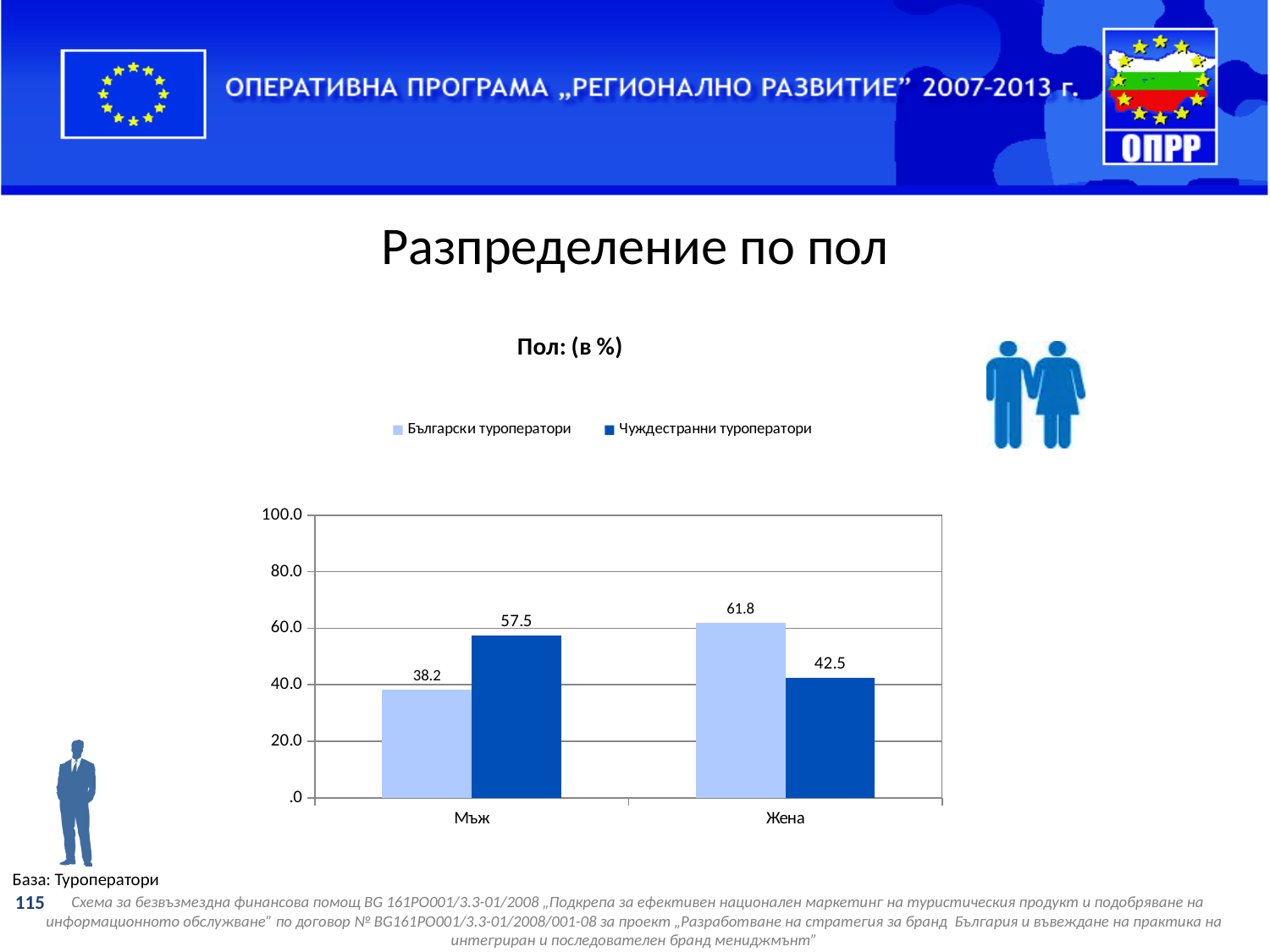
What is the value for Чуждестранни туроператори in the Мъж category? 57.5 What is the value for Чуждестранни туроператори in the Жена category? 42.5 What kind of chart is shown on the slide? Bar chart Which category has the highest value for Български туроператори? Жена What is the difference between the Чуждестранни туроператори and Български туроператори values in the Мъж category? 19.3 How many categories are shown on the x axis? 2 What is the value for Български туроператори in the Жена category? 61.8 Which category has the lowest value for Чуждестранни туроператори? Жена What is the title of the chart? Пол: (в %) How many series does the legend list? 2 What is the value for Български туроператори in the Мъж category? 38.2 Which is larger in the Жена category: Български туроператори or Чуждестранни туроператори? Български туроператори